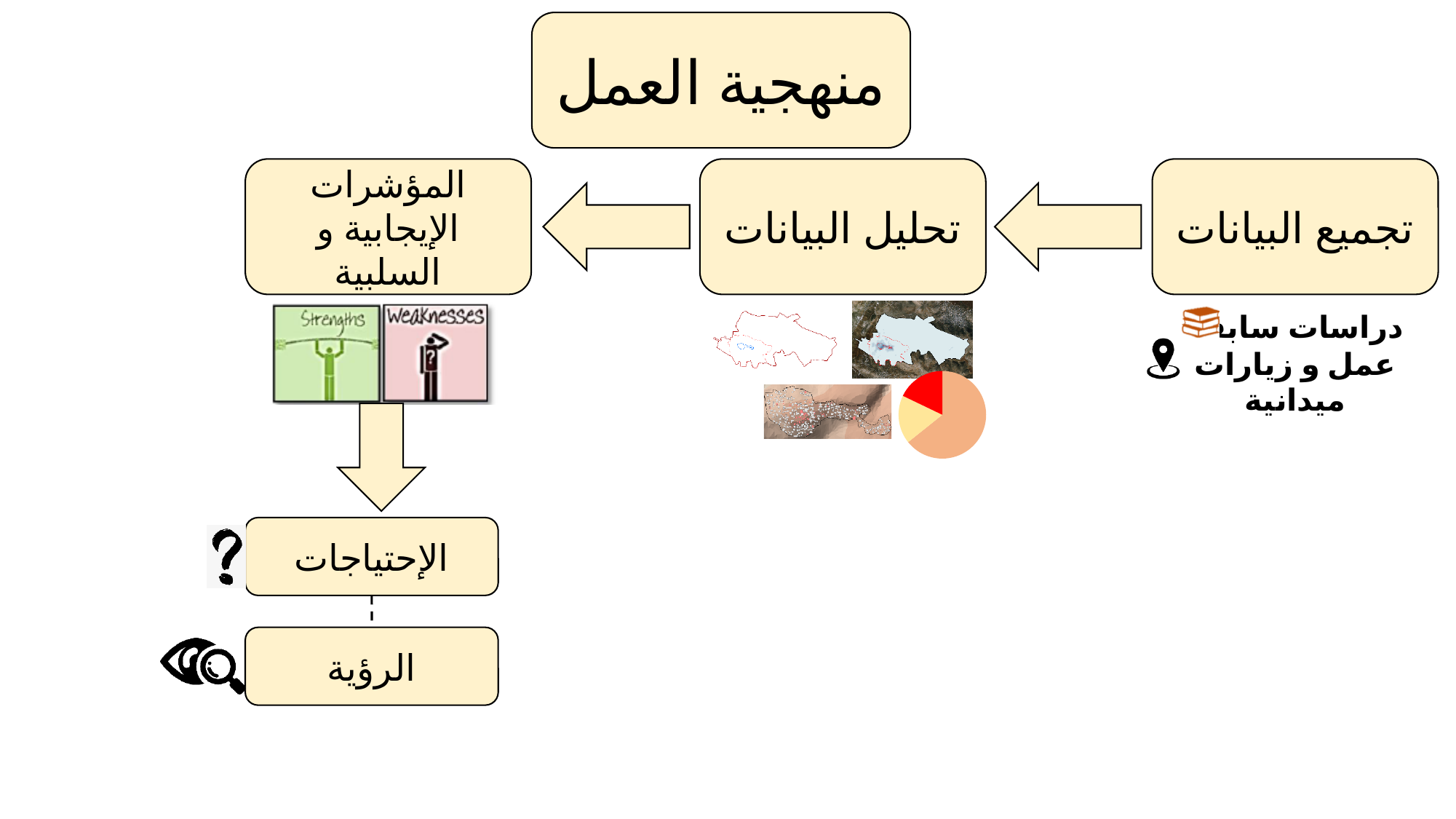
Does the pie chart on the slide have a legend? No Is the orange slice of the pie chart larger or smaller than the yellow slice? larger Which slice of the pie chart is the largest? the orange (peach) slice What kind of chart is shown in the small chart under the "تحليل البيانات" box? pie chart What colours are the slices of the pie chart on the slide? red, yellow and orange How many slices does the pie chart on the slide have? 3 Is the orange slice of the pie chart larger or smaller than the red slice? larger